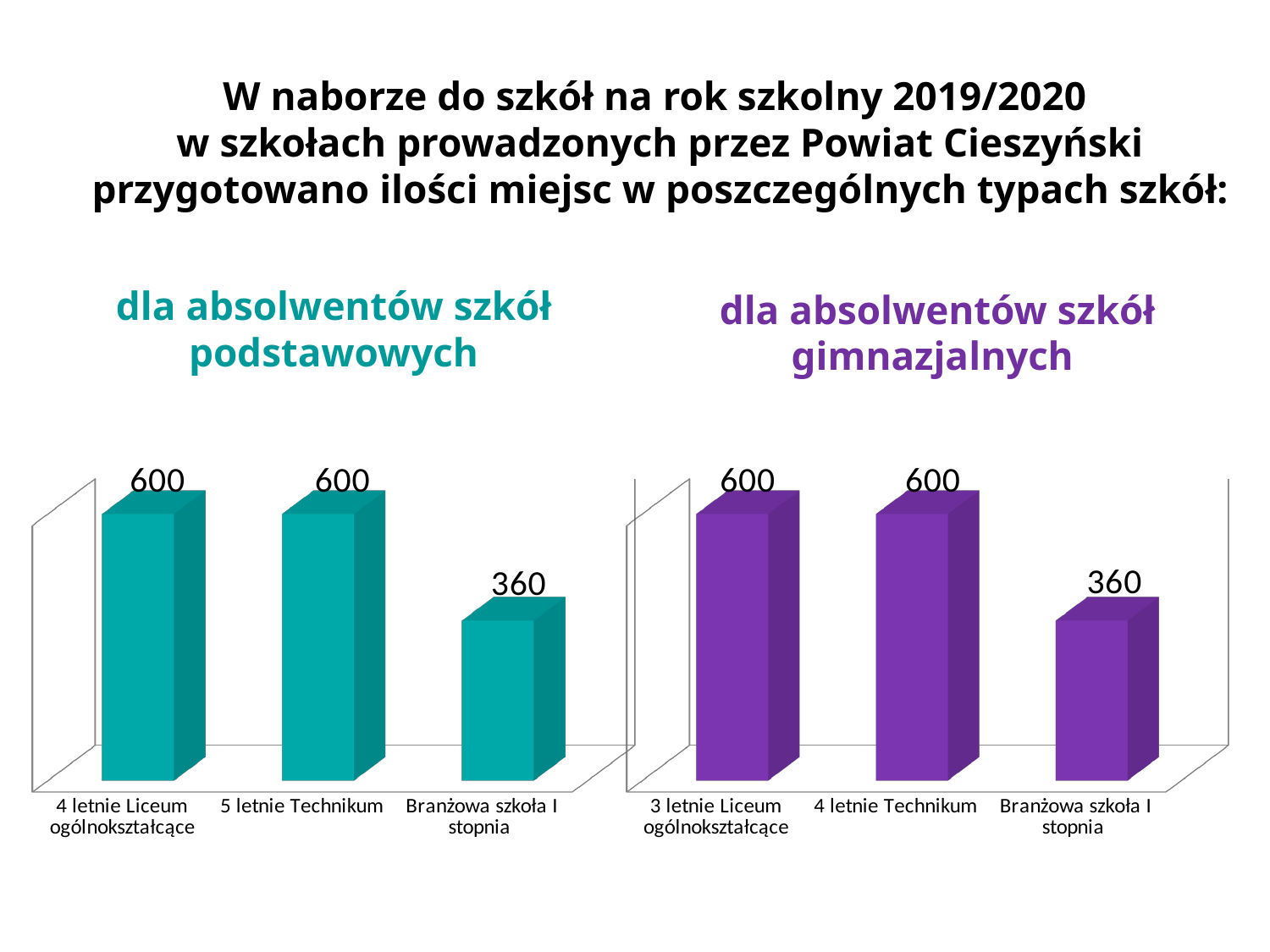
In the right chart (dla absolwentów szkół gimnazjalnych), which category has the lowest value? Branżowa szkoła I stopnia How many categories are shown in the left chart (dla absolwentów szkół podstawowych)? 3 In the right chart (dla absolwentów szkół gimnazjalnych), what is the value for Branżowa szkoła I stopnia? 360 In the left chart (dla absolwentów szkół podstawowych), what is the value for 4 letnie Liceum ogólnokształcące? 600 In the right chart (dla absolwentów szkół gimnazjalnych), which is larger: 3 letnie Liceum ogólnokształcące or Branżowa szkoła I stopnia? 3 letnie Liceum ogólnokształcące What colour are the bars in the left chart (dla absolwentów szkół podstawowych)? teal What kind of chart is the right chart (dla absolwentów szkół gimnazjalnych)? bar chart In the right chart (dla absolwentów szkół gimnazjalnych), what is the difference between 3 letnie Liceum ogólnokształcące and Branżowa szkoła I stopnia? 240 In the right chart (dla absolwentów szkół gimnazjalnych), what is the value for 4 letnie Technikum? 600 In the left chart (dla absolwentów szkół podstawowych), what is the difference between 5 letnie Technikum and Branżowa szkoła I stopnia? 240 In the left chart (dla absolwentów szkół podstawowych), what is the value for Branżowa szkoła I stopnia? 360 In the left chart (dla absolwentów szkół podstawowych), which category has the lowest value? Branżowa szkoła I stopnia